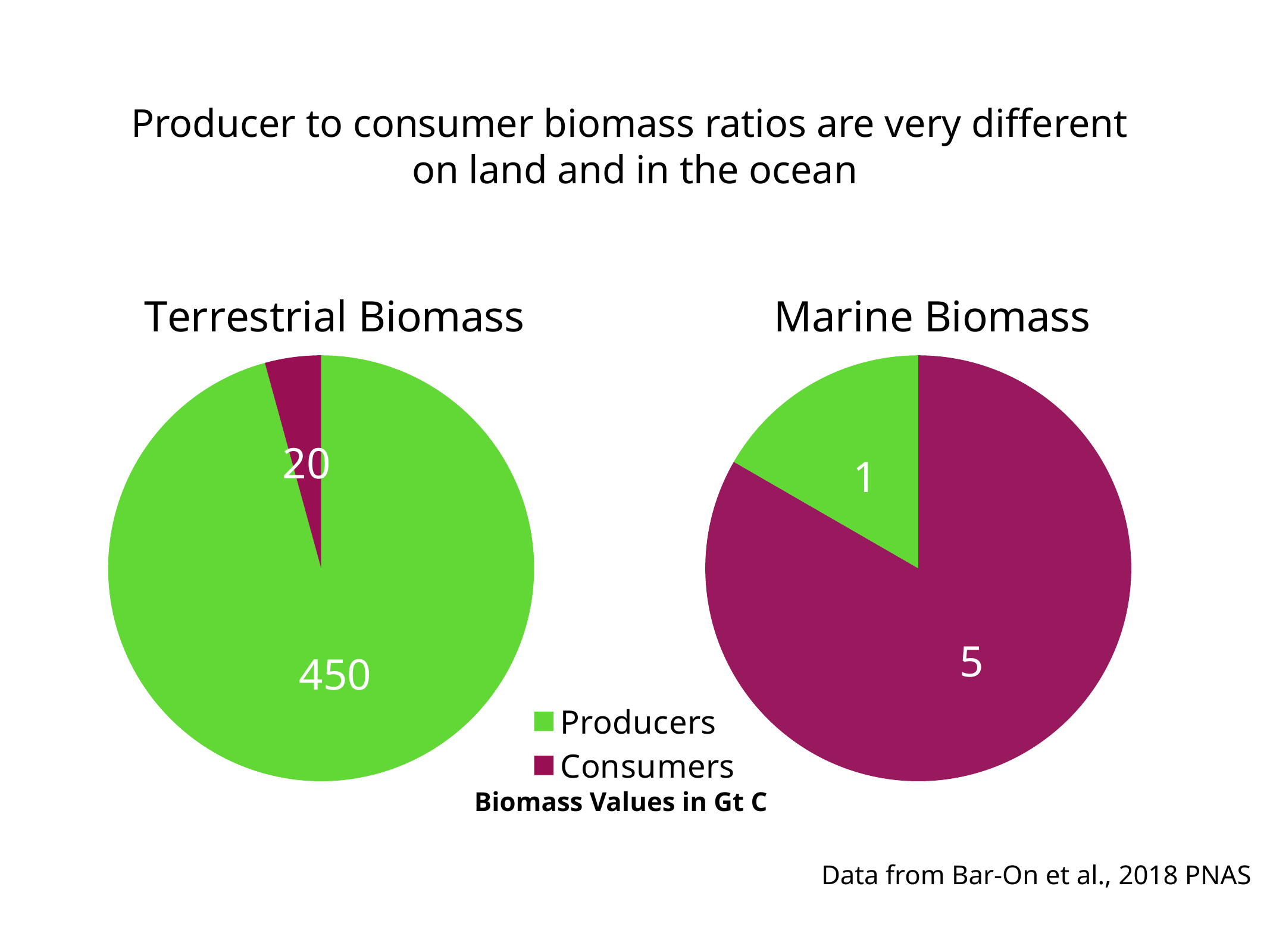
In the Terrestrial Biomass chart, which category has the largest slice? Producers How many categories does the legend list? 2 In the Marine Biomass chart, what is the total of the two slices? 6 In the Terrestrial Biomass chart, what is the value for Producers? 450 What type of chart is the Terrestrial Biomass chart? Pie chart In the Marine Biomass chart, which is larger, Producers or Consumers? Consumers In the Marine Biomass chart, what is the value for Producers? 1 In the Terrestrial Biomass chart, what is the value for Consumers? 20 What unit are the biomass values given in, according to the slide? Gt C In the Marine Biomass chart, which category has the smallest slice? Producers In the Marine Biomass chart, what is the value for Consumers? 5 In the Terrestrial Biomass chart, what is the difference between the Producers and Consumers values? 430